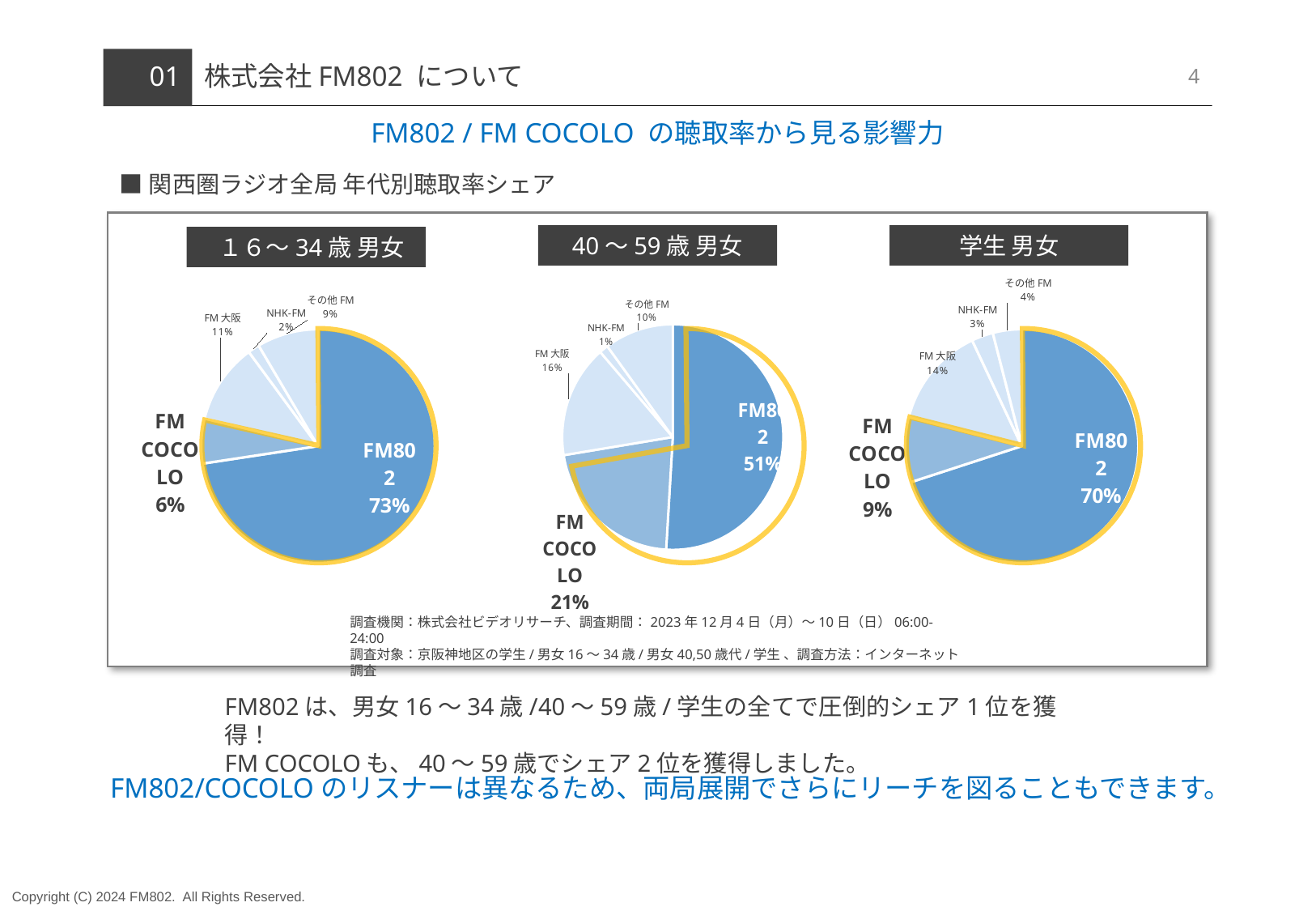
In the 16〜34歳 男女 pie chart, what is the difference between the FM802 share and the FM大阪 share? 62% How many pie charts are shown on the slide? 3 In the 40〜59歳 男女 pie chart, which station has the smallest share? NHK-FM In the 学生 男女 pie chart, which is larger: the share of FM COCOLO or the share of その他FM? FM COCOLO In the 16〜34歳 男女 pie chart, what share does NHK-FM have? 2% In the 40〜59歳 男女 pie chart, what share does FM COCOLO have? 21% What type of chart is used for the 16〜34歳 男女 data? Pie chart In the 40〜59歳 男女 pie chart, what share does その他FM have? 10% In the 16〜34歳 男女 pie chart, what share does FM802 have? 73% How many slices does the 40〜59歳 男女 pie chart have? 5 In the 学生 男女 pie chart, which station has the largest share? FM802 In the 学生 男女 pie chart, what share does FM大阪 have? 14%